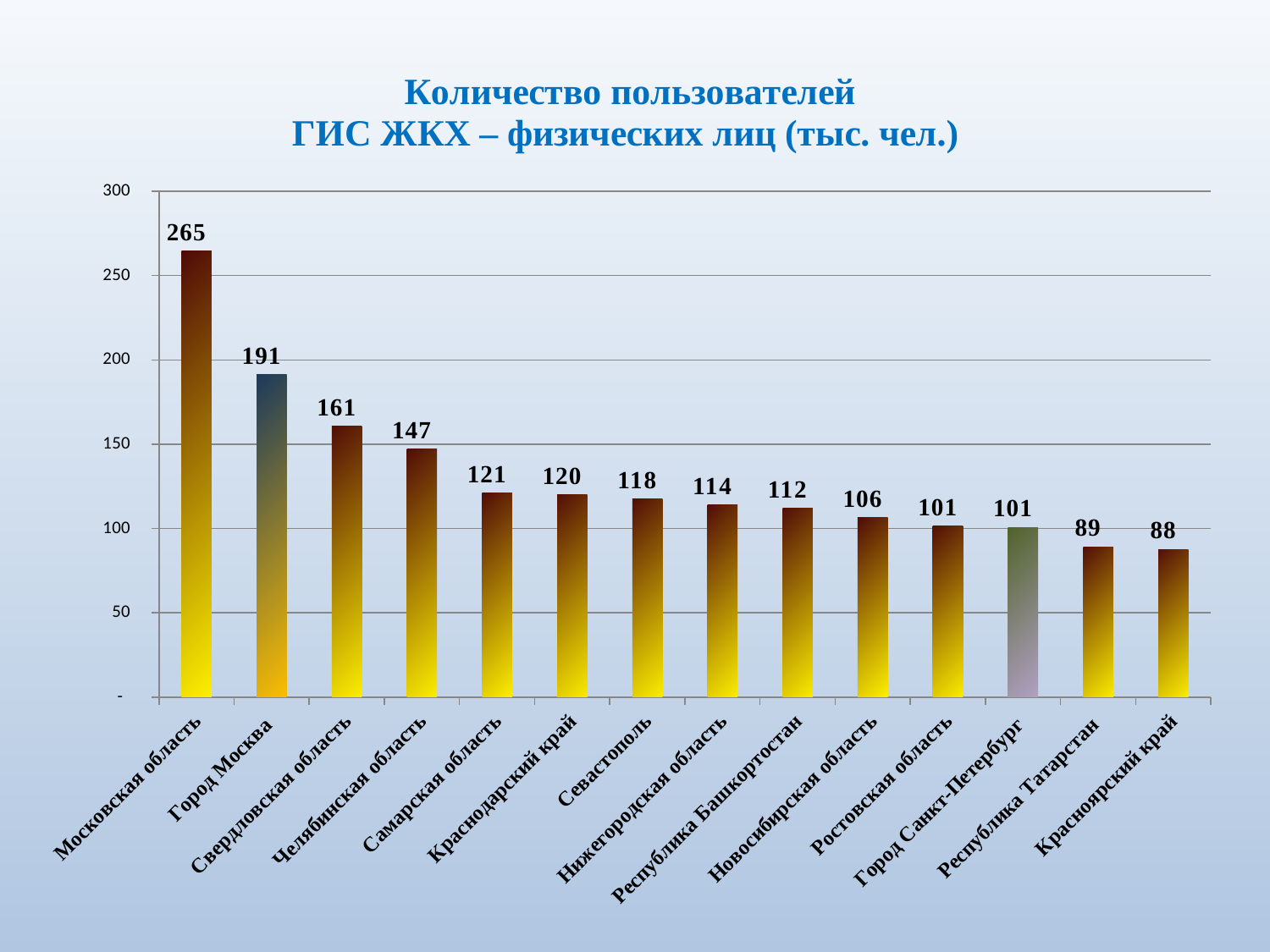
Do the values rise or fall from left to right along the x axis? fall Which is larger, the value for Свердловская область or the value for Челябинская область? Свердловская область What is the value for Красноярский край? 88 Is the value for Севастополь greater or less than 100? greater Which category has the lowest value? Красноярский край What kind of chart is shown on the slide? bar chart How many categories are shown on the chart? 14 What is the value for Республика Башкортостан? 112 What is the difference between the values for Московская область and Город Москва? 74 What is the value for Город Москва? 191 Which category has the highest value? Московская область What is the value for Московская область? 265